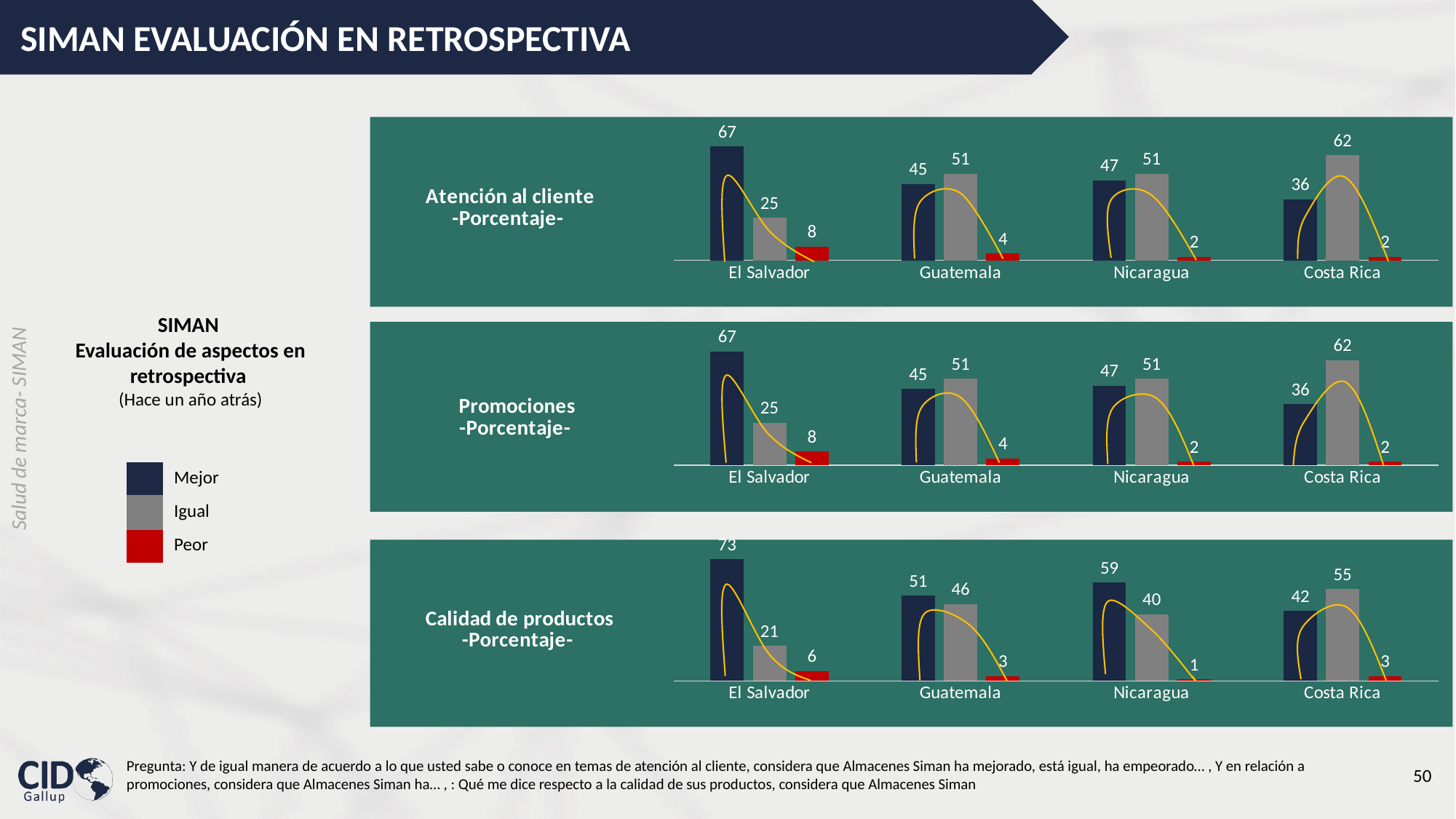
In the 'Calidad de productos' chart, which country has the lowest 'Peor' value? Nicaragua In the 'Atención al cliente' chart, what is the difference between the 'Mejor' values for El Salvador and Costa Rica? 31 What type of chart is the 'Atención al cliente' chart? Bar chart How many series does the legend on the slide list? 3 In the 'Atención al cliente' chart, which country has the highest 'Igual' value? Costa Rica In the 'Promociones' chart, which country has the lowest 'Mejor' value? Costa Rica In the 'Calidad de productos' chart, what is the 'Mejor' value for Nicaragua? 59 How many countries are shown on the x axis of the 'Calidad de productos' chart? 4 In the 'Promociones' chart, what is the 'Peor' value for Guatemala? 4 In the 'Calidad de productos' chart, what is the difference between the 'Mejor' and 'Igual' values for El Salvador? 52 In the 'Atención al cliente' chart, what is the 'Mejor' value for El Salvador? 67 In the 'Promociones' chart, is the 'Igual' value for Nicaragua larger or smaller than its 'Mejor' value? larger